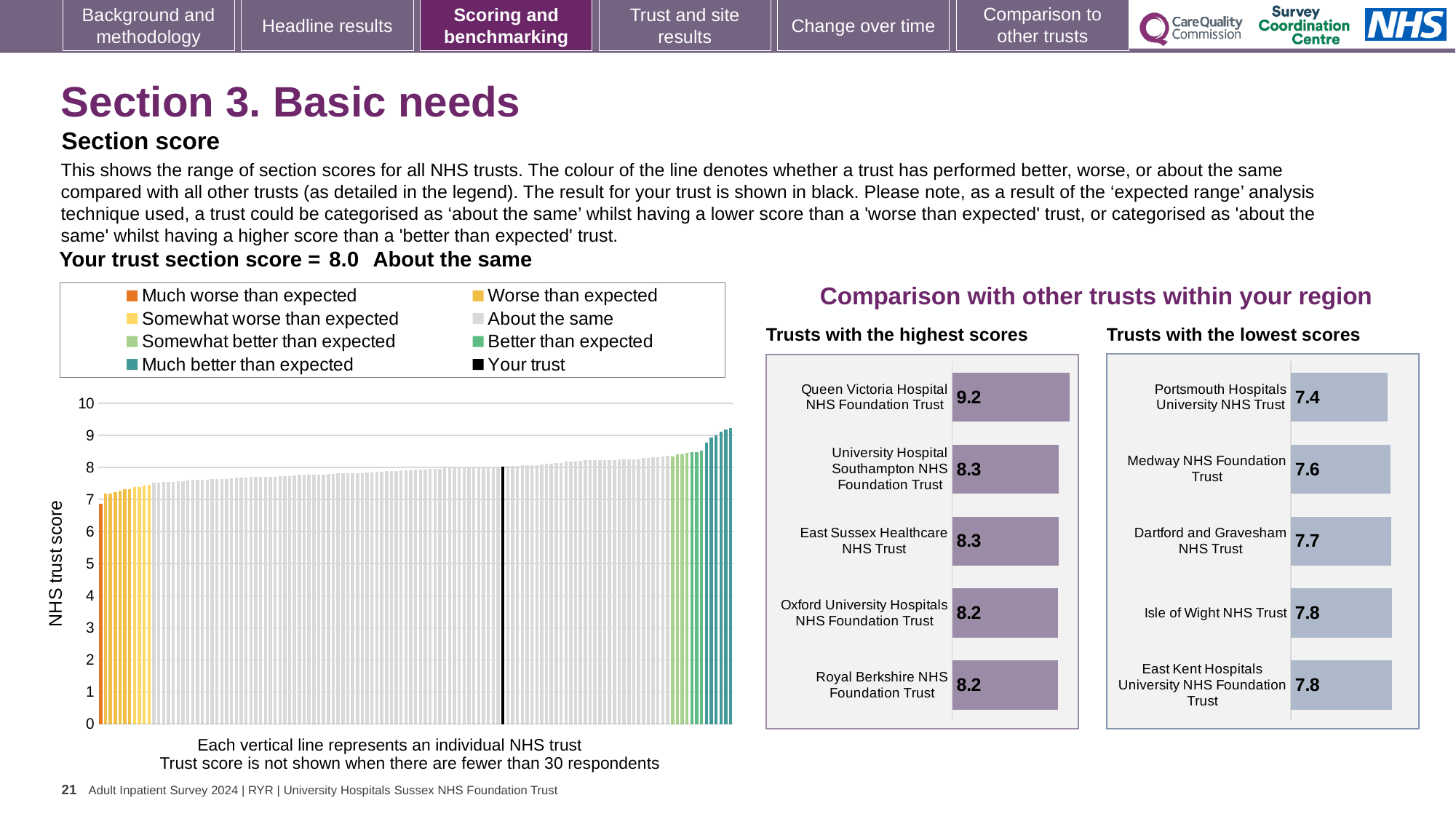
In the 'Trusts with the lowest scores' chart, which has the larger score: Medway NHS Foundation Trust or Dartford and Gravesham NHS Trust? Dartford and Gravesham NHS Trust In the 'Trusts with the highest scores' chart, what is the score for Queen Victoria Hospital NHS Foundation Trust? 9.2 In the 'Trusts with the lowest scores' chart, which trust has the lowest score? Portsmouth Hospitals University NHS Trust How many entries does the legend of the main 'NHS trust score' chart list? 8 According to the slide, what is your trust's section score shown in the main chart? 8.0 In the 'Trusts with the highest scores' chart, what is the difference between the scores of Queen Victoria Hospital NHS Foundation Trust and University Hospital Southampton NHS Foundation Trust? 0.9 In the 'Trusts with the lowest scores' chart, what is the score for Isle of Wight NHS Trust? 7.8 How many trusts are shown in the 'Trusts with the highest scores' chart? 5 In the main chart on the left, do the trust scores rise or fall from left to right along the x axis? Rise In the 'Trusts with the highest scores' chart, which trust has the highest score? Queen Victoria Hospital NHS Foundation Trust What kind of chart is the main chart on the left showing NHS trust scores? Bar chart In the 'Trusts with the lowest scores' chart, what is the difference between the scores of East Kent Hospitals University NHS Foundation Trust and Portsmouth Hospitals University NHS Trust? 0.4